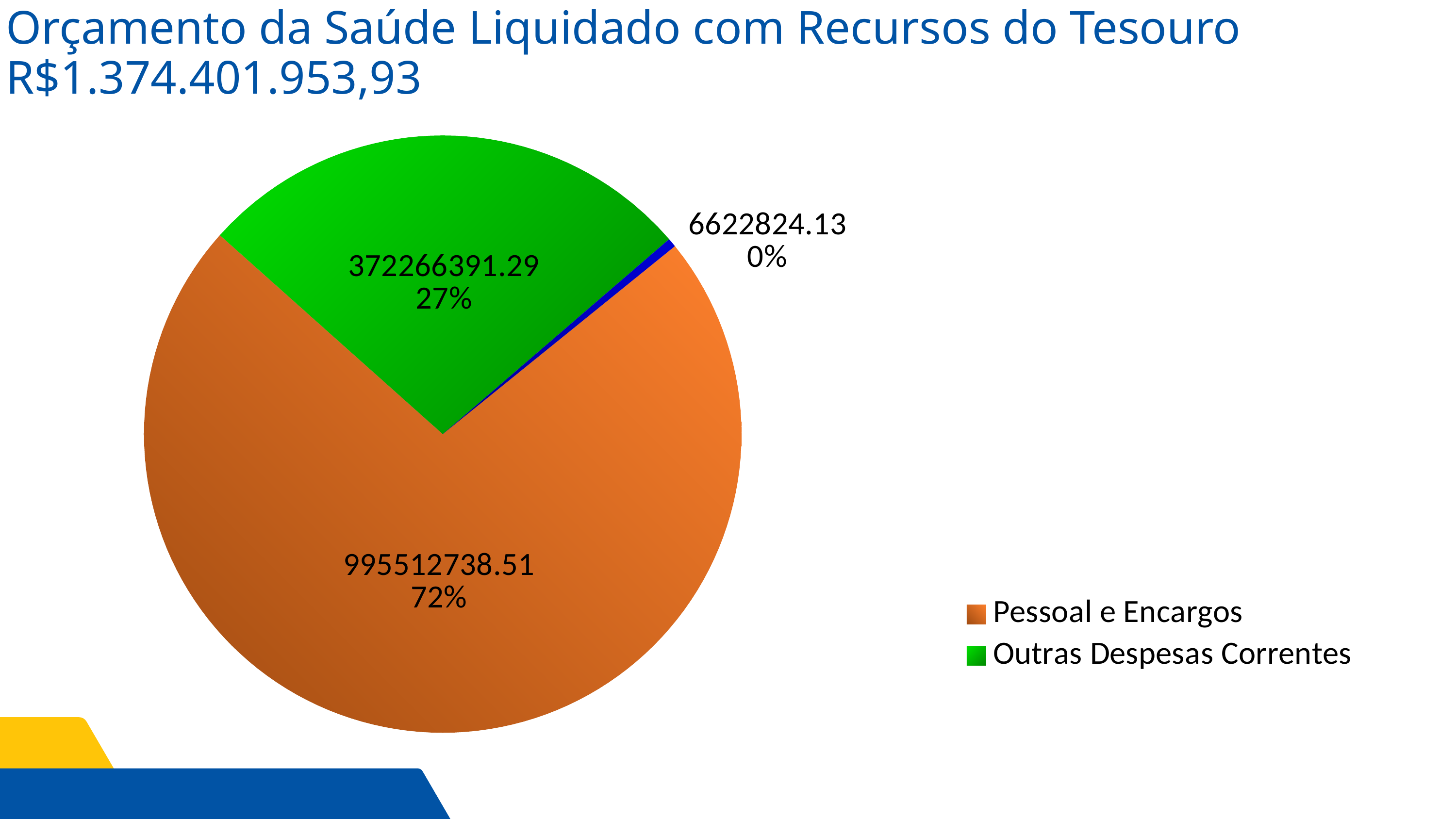
What share of the pie does Outras Despesas Correntes represent? 27% What is the value shown for Outras Despesas Correntes? 372266391.29 How many slices does the pie chart have? 3 What type of chart is shown on the slide? Pie chart How many entries does the legend list? 2 Which is larger, Pessoal e Encargos or Outras Despesas Correntes? Pessoal e Encargos What is the difference between the values for Pessoal e Encargos and Outras Despesas Correntes? 623246347.22 Which category has the largest slice of the pie? Pessoal e Encargos What colour is the slice for Outras Despesas Correntes? Green What is the value shown for Pessoal e Encargos? 995512738.51 What share of the pie does Pessoal e Encargos represent? 72% What value is printed on the slice labelled 0%? 6622824.13